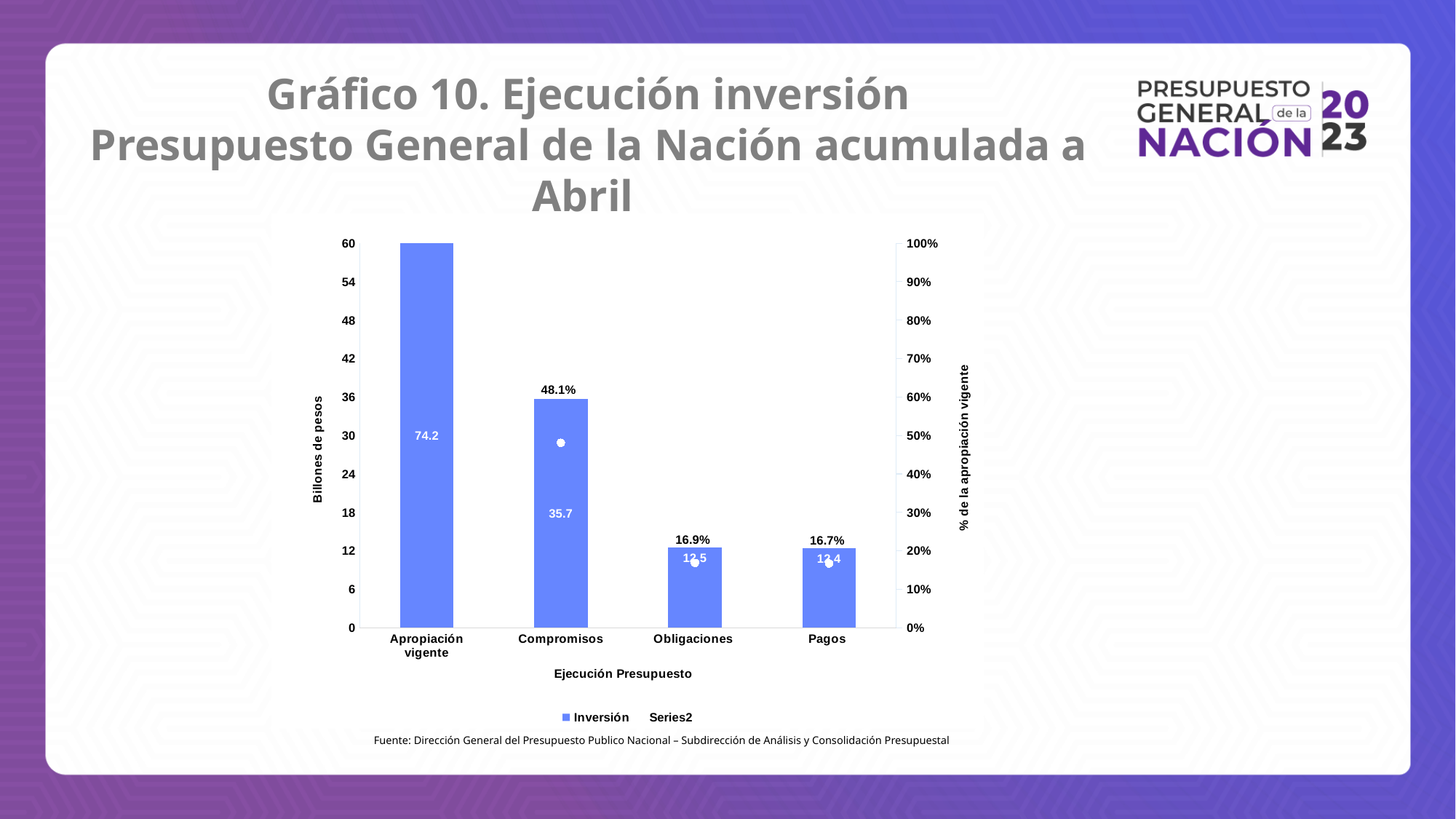
What percentage of the apropiación vigente is shown for Obligaciones? 16.9% How many series does the legend list? 2 How many categories are shown on the x axis? 4 Which is larger, the Inversión value for Compromisos or for Obligaciones? Compromisos What kind of chart is this? Bar chart What percentage of the apropiación vigente is shown for Pagos? 16.7% What is the Inversión value for Apropiación vigente? 74.2 Which category has the highest Inversión value? Apropiación vigente What is the label of the left vertical axis? Billones de pesos What percentage of the apropiación vigente is shown for Compromisos? 48.1% What is the difference between the Inversión values for Apropiación vigente and Compromisos? 38.5 What is the Inversión value for Compromisos? 35.7